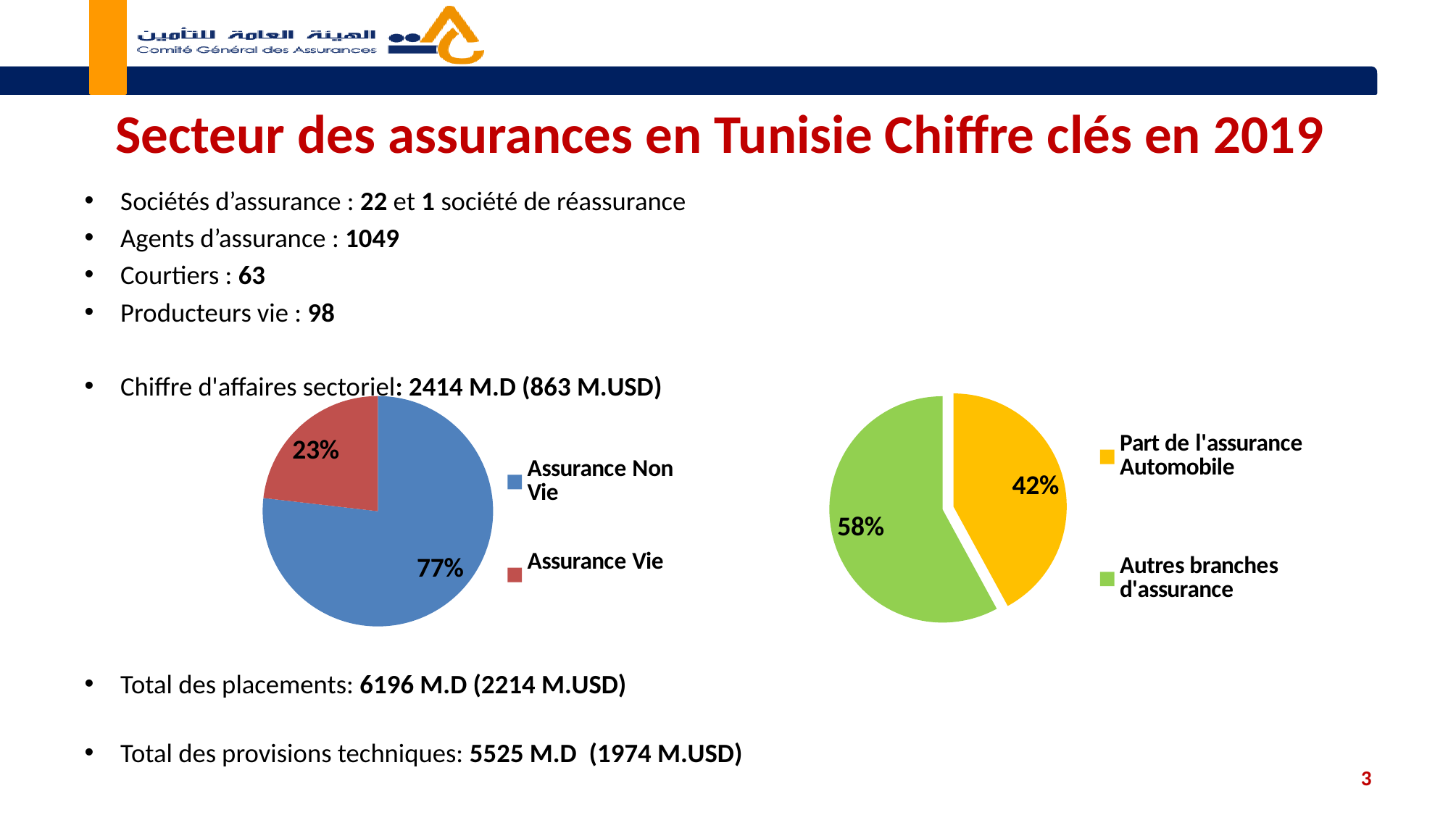
In the right pie chart, what share is labelled for Autres branches d'assurance? 58% What kind of chart is the left chart? Pie chart In the right pie chart, which slice is the smallest? Part de l'assurance Automobile In the left pie chart, what colour is the Assurance Vie slice? Red In the right pie chart, what is the difference in percentage points between Autres branches d'assurance and Part de l'assurance Automobile? 16 How many slices does the right pie chart have? 2 In the left pie chart, what is the difference in percentage points between Assurance Non Vie and Assurance Vie? 54 In the right pie chart, which is larger: Part de l'assurance Automobile or Autres branches d'assurance? Autres branches d'assurance In the right pie chart, what share is labelled for Part de l'assurance Automobile? 42% In the left pie chart, which slice is the largest? Assurance Non Vie In the left pie chart, what share is labelled for Assurance Vie? 23% In the left pie chart, what share is labelled for Assurance Non Vie? 77%